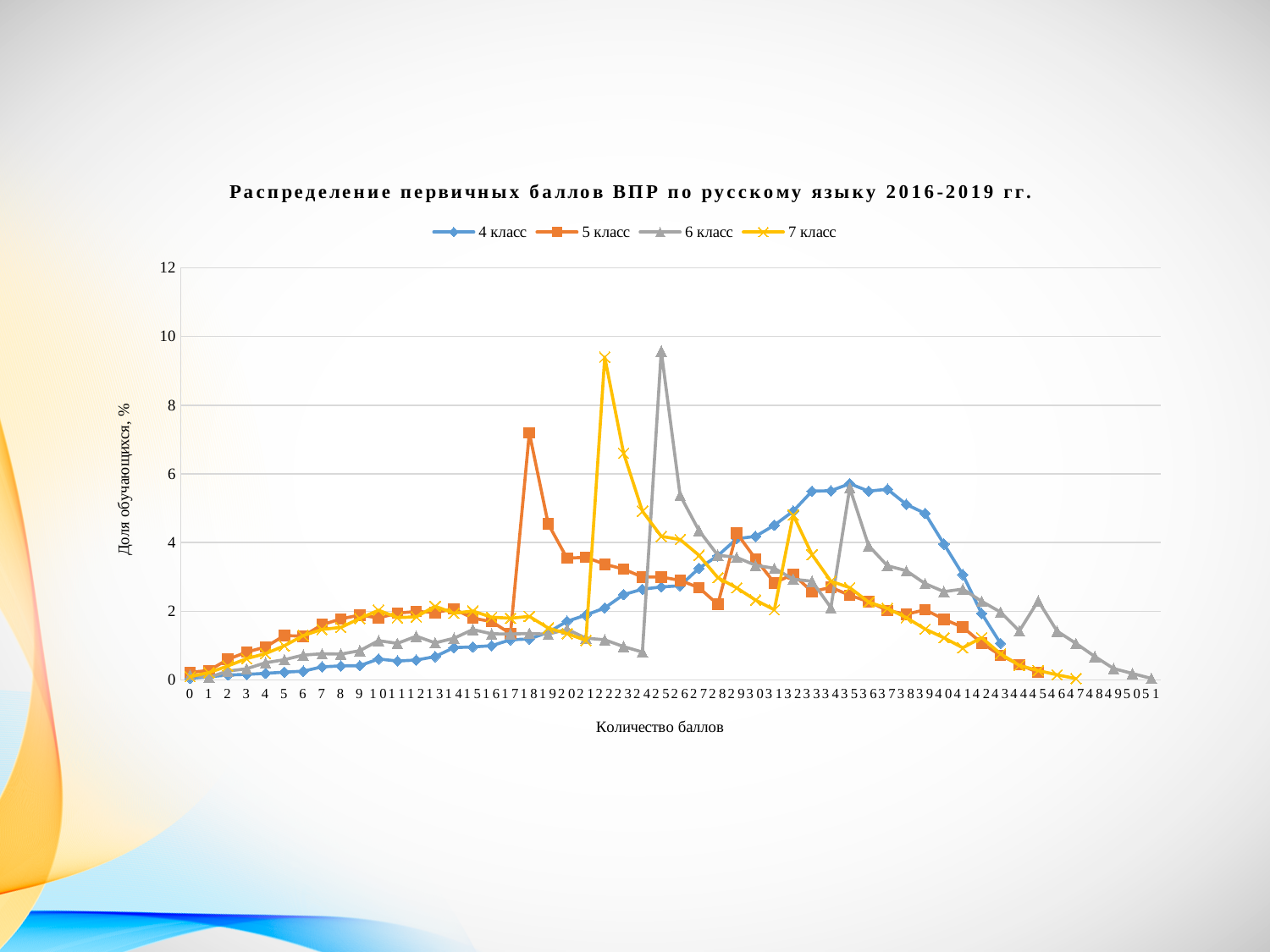
What is the title of the chart? Распределение первичных баллов ВПР по русскому языку 2016-2019 гг. What kind of chart is shown on the slide? line chart Is the peak value of the 5 класс series greater or less than 6? greater Is the peak value of the 4 класс series greater or less than 6? less At a score of 35, which series has the larger value: 4 класс or 5 класс? 4 класс How many series does the legend list? 4 Does the 4 класс line rise or fall between scores 37 and 43? fall Is the peak value of the 6 класс series greater or less than 8? greater What is the label of the vertical axis? Доля обучающихся, % Which series has the lowest peak value? 4 класс At a score of 18, which series has the larger value: 4 класс or 5 класс? 5 класс